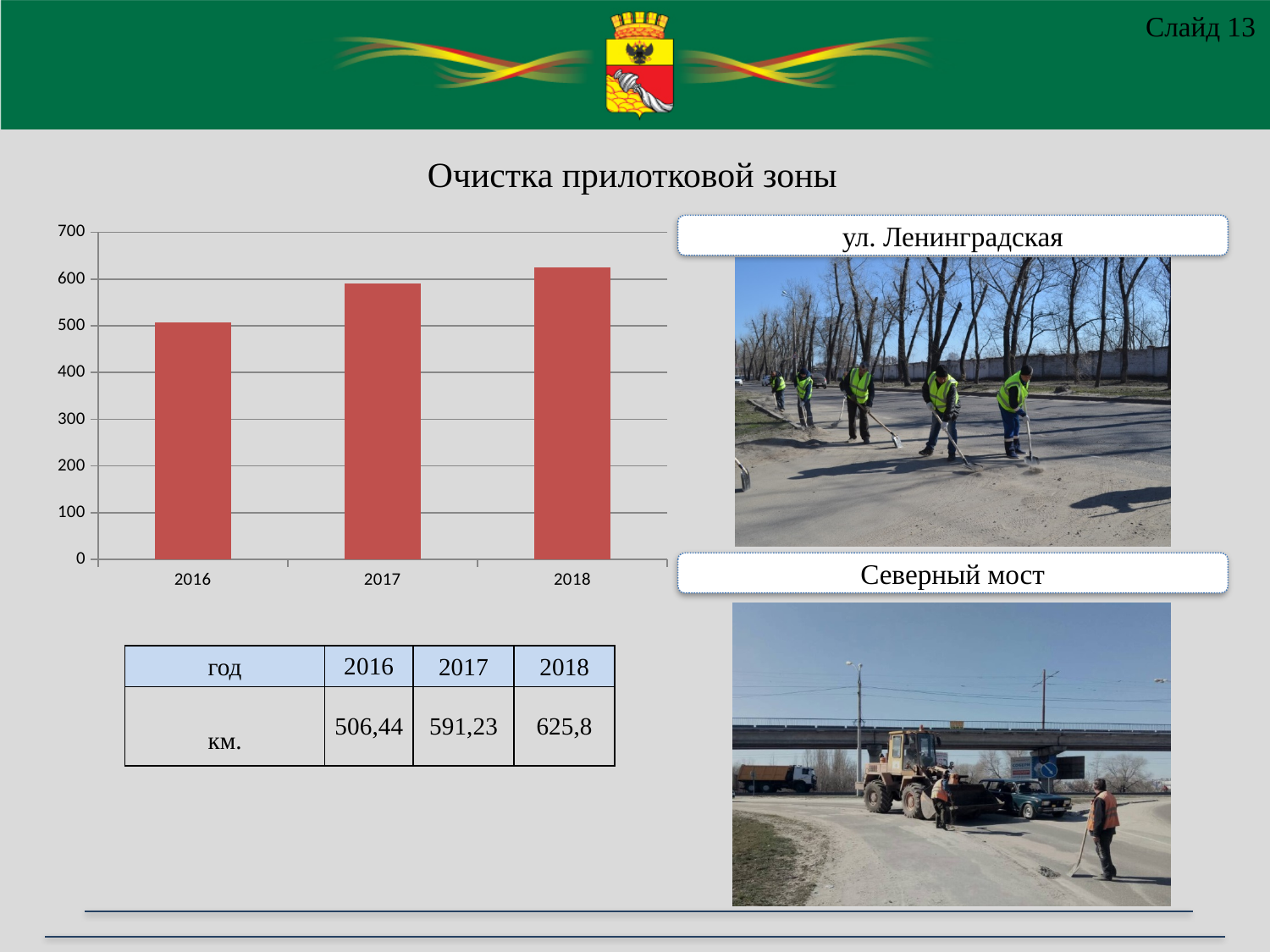
Is the value for 2017 greater or less than 500? greater How many bars (years) does the chart show? 3 According to the table under the chart, what is the value (km.) for 2018? 625,8 Which year has the highest bar in the chart? 2018 What kind of chart is shown on the slide? bar chart Using the values in the table, what is the difference between 2018 and 2016? 119,36 Is the value for 2016 greater or less than 600? less Which year has the lowest bar in the chart? 2016 Do the values rise or fall from 2016 to 2018? rise What is the title of the slide above the chart? Очистка прилотковой зоны According to the table under the chart, what is the value (km.) for 2016? 506,44 Is the value for 2018 greater or less than 600? greater